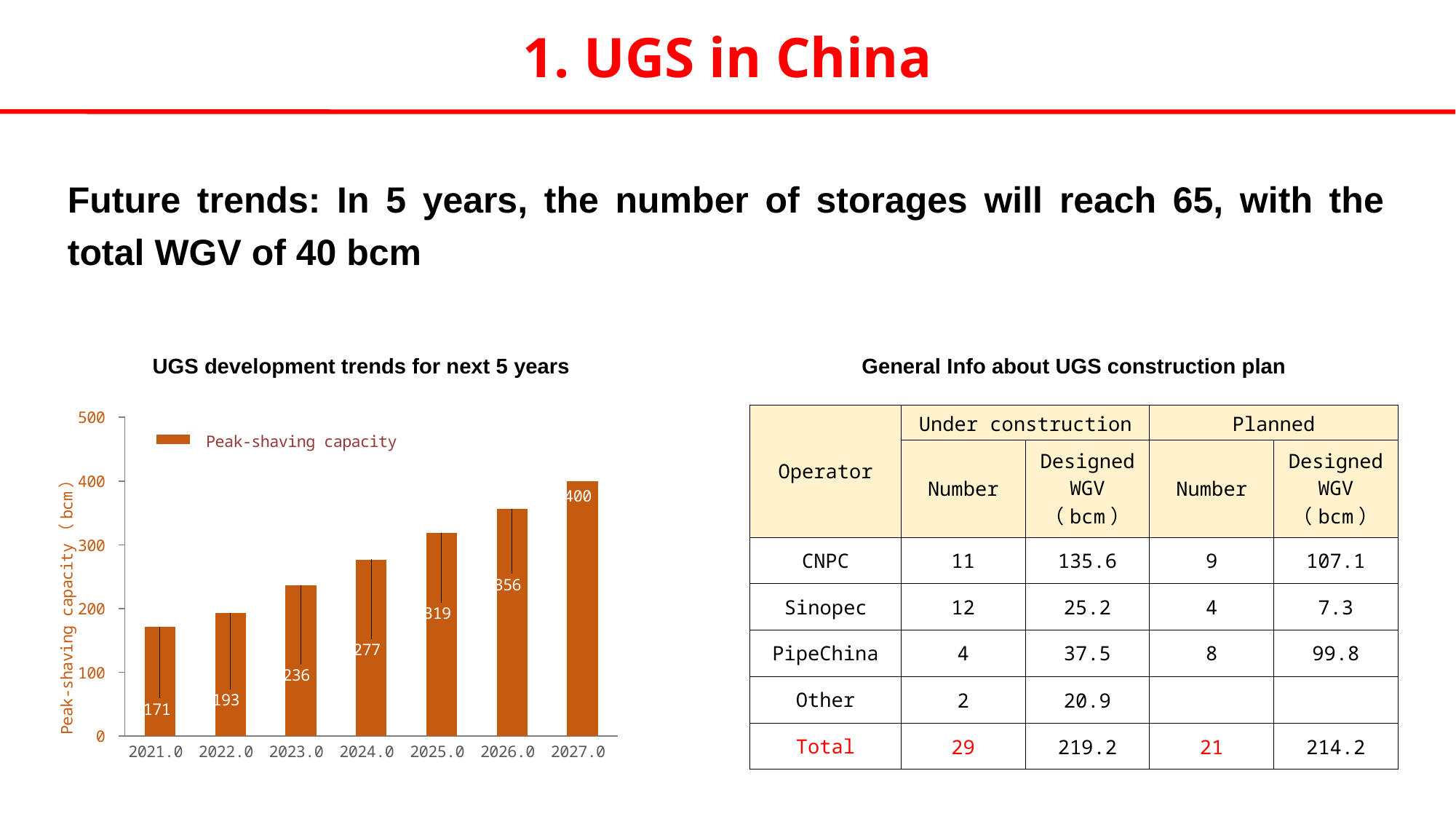
What is the peak-shaving capacity for 2024.0? 277 How many years are plotted on the x axis of the chart? 7 What is the difference in peak-shaving capacity between 2026.0 and 2025.0? 37 Which year has the lowest peak-shaving capacity? 2021.0 Does the peak-shaving capacity rise or fall from 2021.0 to 2027.0? rise Which is larger, the peak-shaving capacity for 2023.0 or for 2025.0? 2025.0 What type of chart is shown under the title "UGS development trends for next 5 years"? bar chart What is the difference in peak-shaving capacity between 2027.0 and 2021.0? 229 Which year has the highest peak-shaving capacity? 2027.0 What is the peak-shaving capacity for 2021.0? 171 What series name does the chart legend show? Peak-shaving capacity What is the peak-shaving capacity for 2027.0? 400